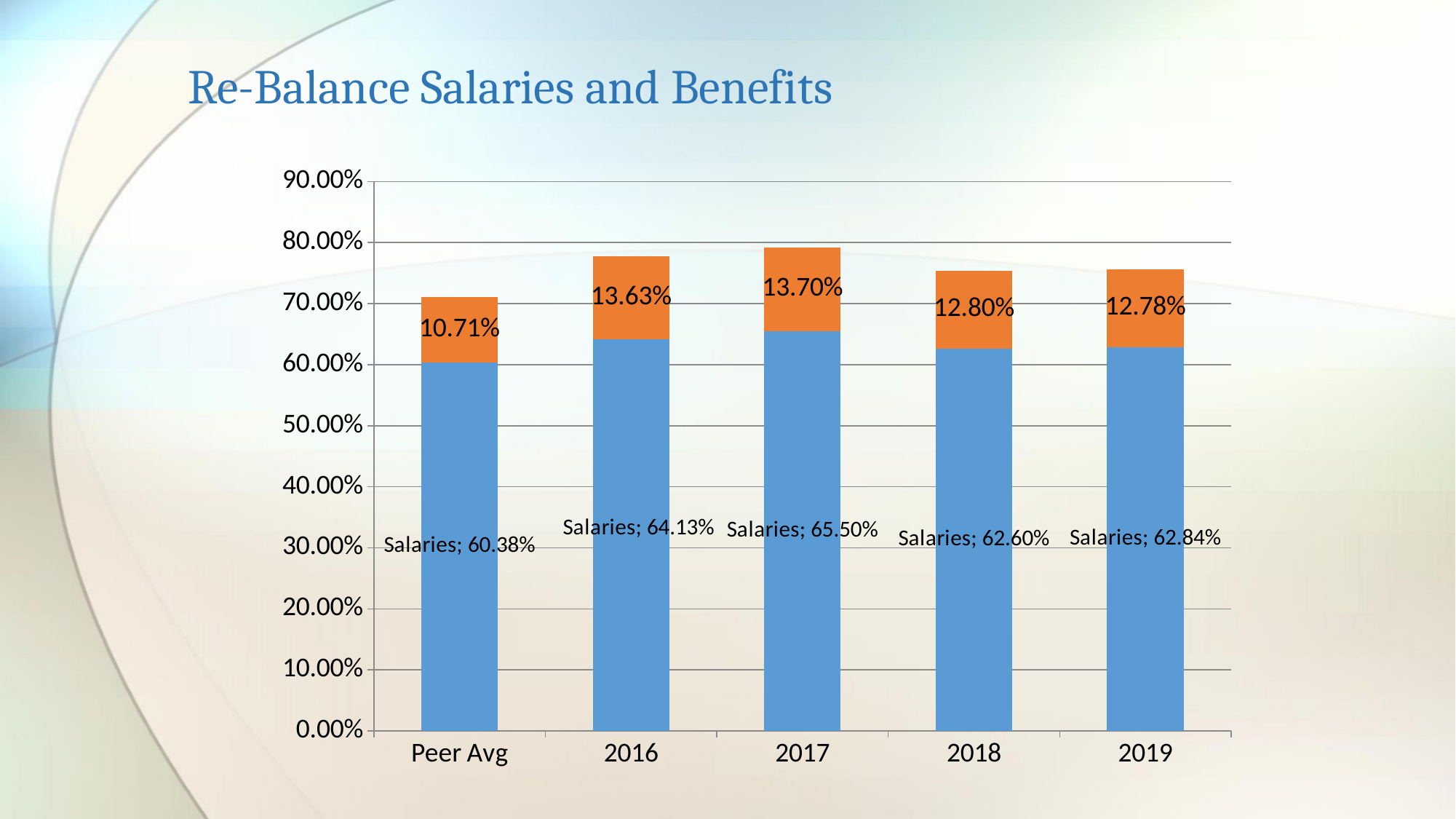
What is the value of the orange segment for 2018? 12.80% Which category has the highest value for the orange segment? 2017 What is the value of the orange segment for Peer Avg? 10.71% How many categories are shown on the x axis? 5 Is the total of the stacked bar for Peer Avg greater or less than 70.00%? greater What is the Salaries value for 2017? 65.50% Which has the larger Salaries value, 2018 or 2019? 2019 Which category has the highest Salaries value? 2017 What is the difference between the Salaries values for 2017 and 2016? 1.37% Which category has the lowest Salaries value? Peer Avg What is the total height of the stacked bar for Peer Avg? 71.09% What type of chart is shown on the slide? Stacked bar chart